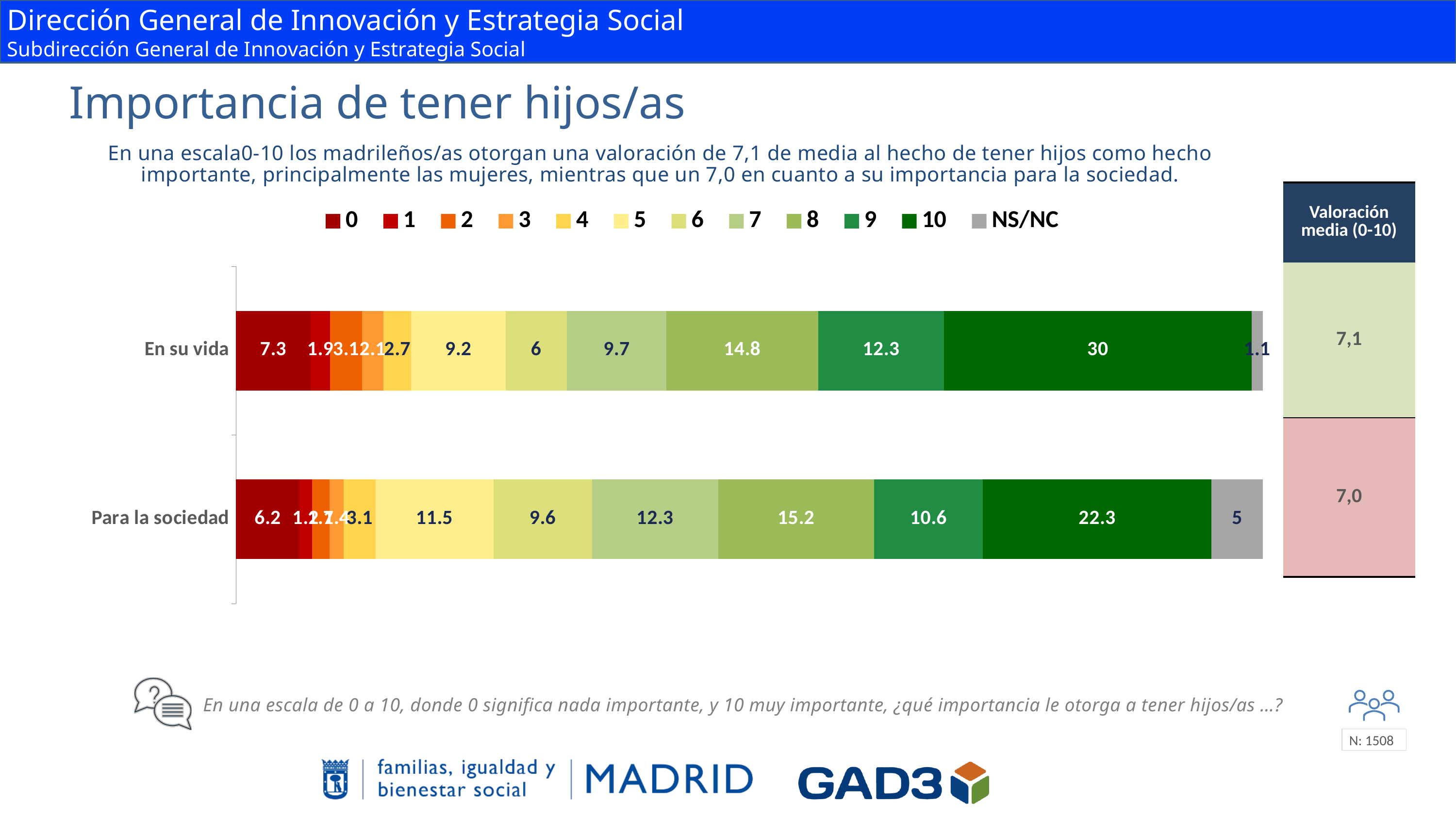
What is the value for score 8 in the 'En su vida' bar? 14.8 What percentage of respondents gave a score of 10 for 'En su vida'? 30 Which bar has the larger value for score 9, 'En su vida' or 'Para la sociedad'? En su vida What is the value for score 5 in the 'Para la sociedad' bar? 11.5 How many series does the legend list? 12 What is the difference between the score-10 values for 'En su vida' and 'Para la sociedad'? 7.7 What is the NS/NC value for 'Para la sociedad'? 5 How many bars (categories) does the chart show? 2 Which score has the largest segment in the 'Para la sociedad' bar? 10 What is the 'Valoración media (0-10)' shown for 'En su vida'? 7,1 What percentage of respondents gave a score of 10 for 'Para la sociedad'? 22.3 Which score has the largest segment in the 'En su vida' bar? 10